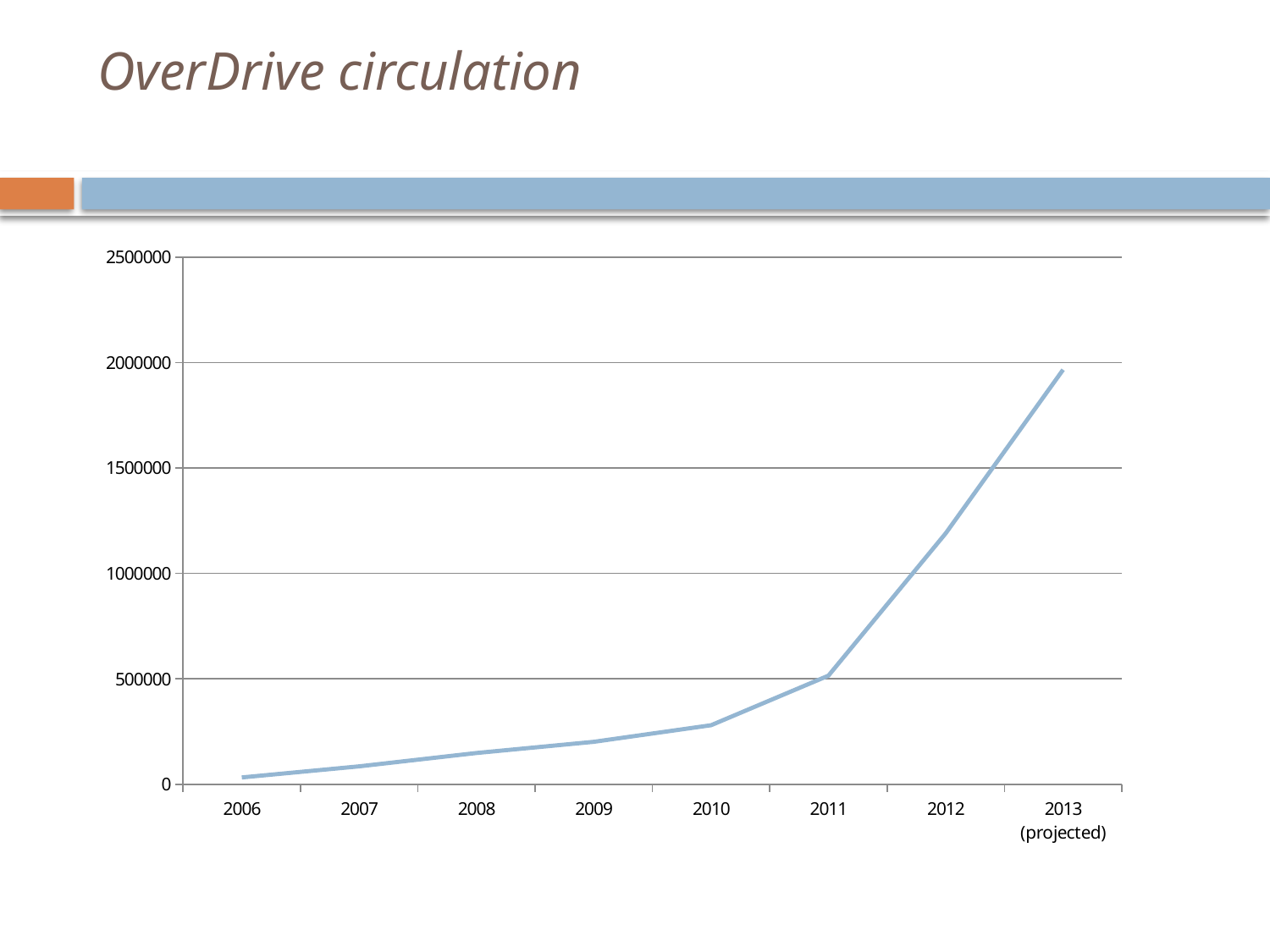
Do the values rise or fall from 2006 to 2013? rise Is the value for 2012 greater or less than 1000000? greater What is the title of the slide? OverDrive circulation Which is larger, the value for 2012 or the value for 2011? 2012 What is the highest value shown on the y axis? 2500000 What kind of chart is shown on the slide? line chart Is the value for 2011 greater or less than 1000000? less Which year has the highest circulation value? 2013 (projected) Is the value for 2013 (projected) greater or less than 1500000? greater How many years are plotted on the x axis? 8 Which year has the lowest circulation value? 2006